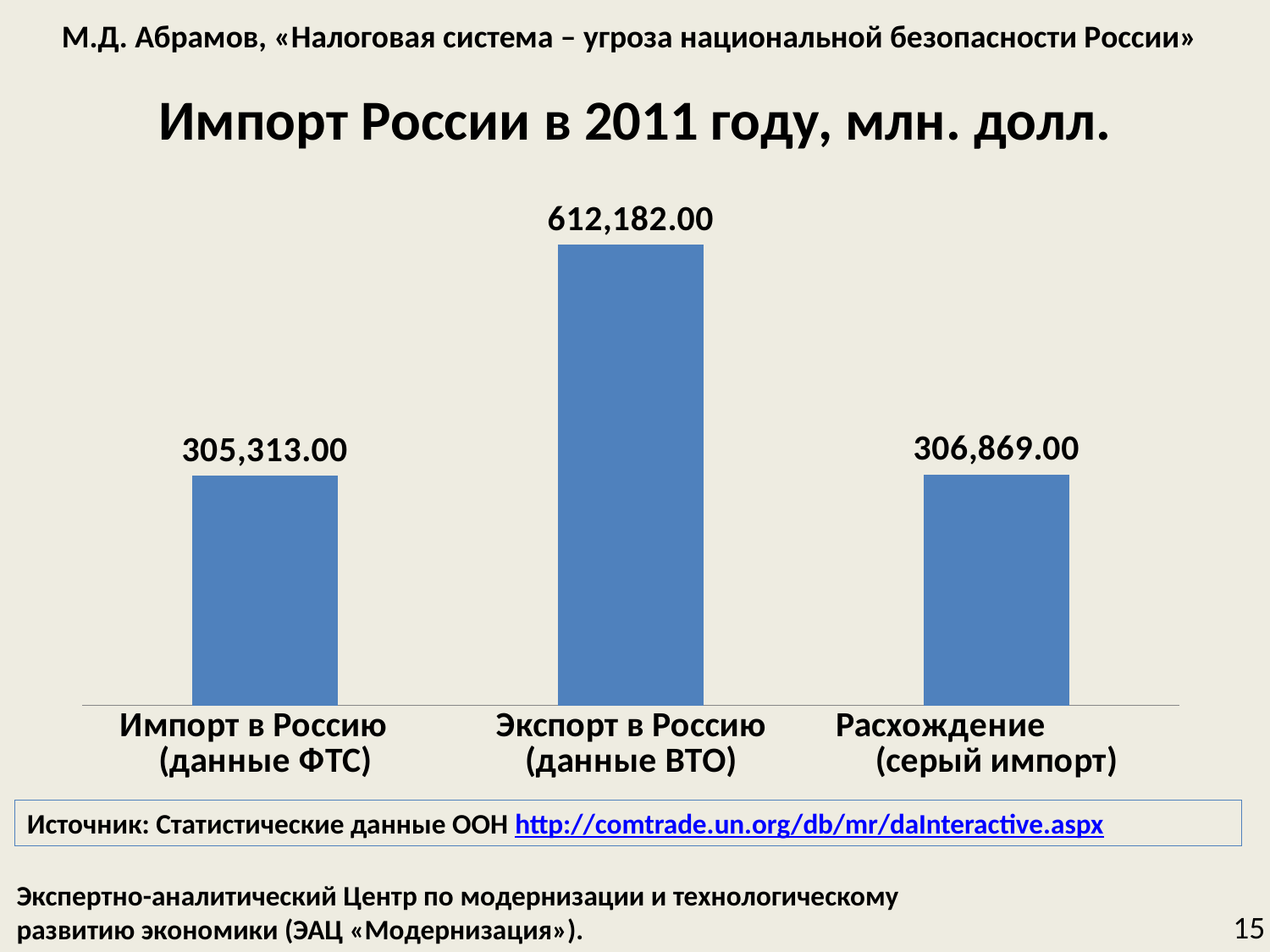
What is the title of the chart? Импорт России в 2011 году, млн. долл. What is the value for Расхождение (серый импорт)? 306,869.00 What is the difference between the values for Экспорт в Россию (данные ВТО) and Импорт в Россию (данные ФТС)? 306,869.00 Which category has the lowest value? Импорт в Россию (данные ФТС) Which category has the highest value? Экспорт в Россию (данные ВТО) Which is larger: the value for Импорт в Россию (данные ФТС) or the value for Расхождение (серый импорт)? Расхождение (серый импорт) What is the value for Импорт в Россию (данные ФТС)? 305,313.00 What is the difference between the values for Расхождение (серый импорт) and Импорт в Россию (данные ФТС)? 1,556.00 What kind of chart is shown on the slide? Bar chart Which is larger: the value for Экспорт в Россию (данные ВТО) or the value for Расхождение (серый импорт)? Экспорт в Россию (данные ВТО) What is the value for Экспорт в Россию (данные ВТО)? 612,182.00 How many categories are shown in the chart? 3